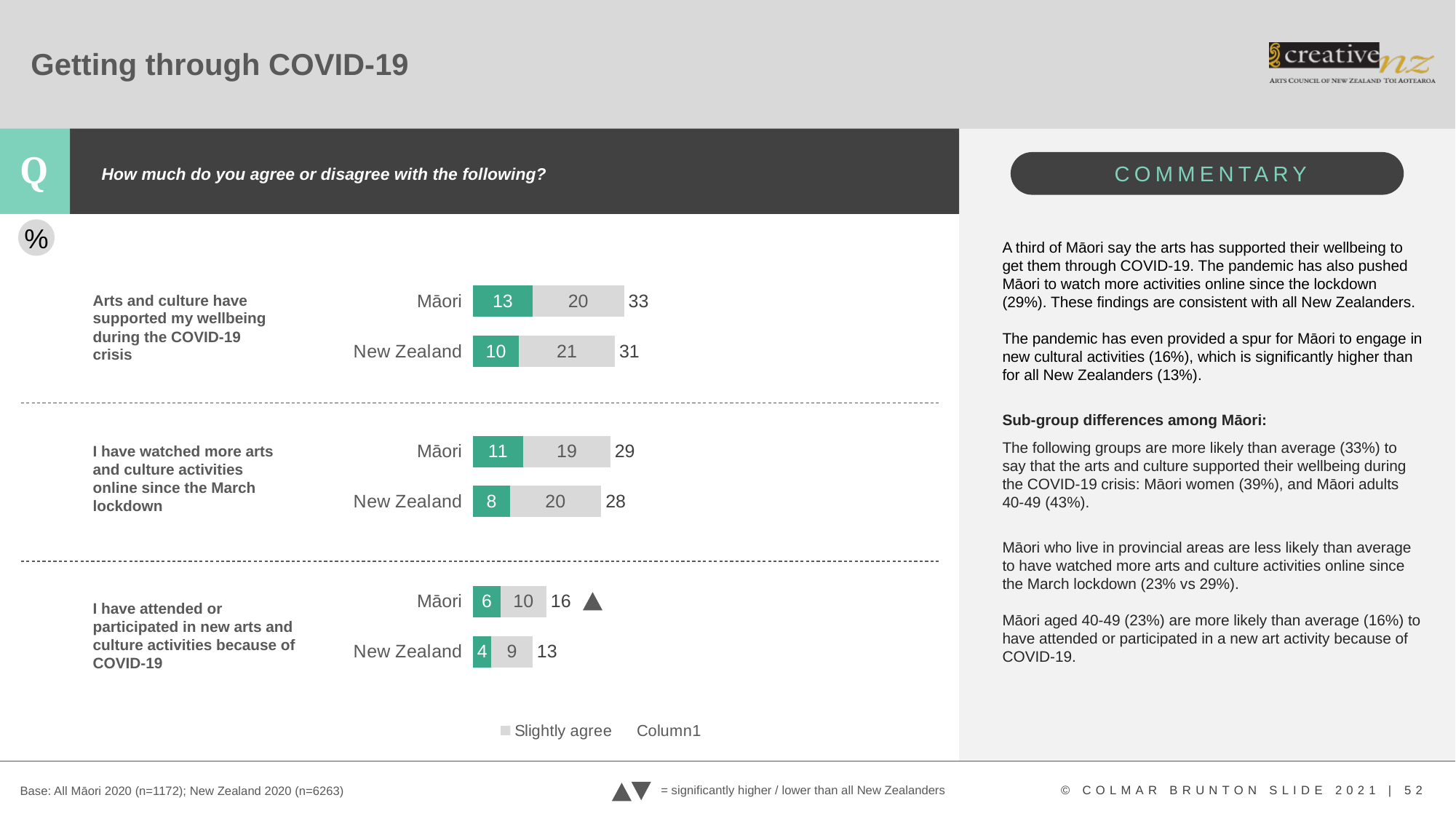
In the chart for 'Arts and culture have supported my wellbeing during the COVID-19 crisis', what is the value of the green segment for New Zealand? 10 How many entries does the legend at the bottom of the chart list? 2 In the chart for 'Arts and culture have supported my wellbeing during the COVID-19 crisis', which group has the larger total, Māori or New Zealand? Māori How many statements (question items) are shown in the chart area? 3 What type of chart is used to show the responses on this slide? Bar chart Across the three statements, which statement has the highest total for New Zealand? Arts and culture have supported my wellbeing during the COVID-19 crisis In the chart for 'I have attended or participated in new arts and culture activities because of COVID-19', what is the total value shown for New Zealand? 13 In the chart for 'I have watched more arts and culture activities online since the March lockdown', what is the sum of the green and grey segments for New Zealand? 28 In the chart for 'I have watched more arts and culture activities online since the March lockdown', what is the 'Slightly agree' (grey) value for Māori? 19 In the chart for 'I have attended or participated in new arts and culture activities because of COVID-19', what is the difference between the Māori total and the New Zealand total? 3 In the chart for 'Arts and culture have supported my wellbeing during the COVID-19 crisis', what is the total value shown for Māori? 33 Across the three statements, which statement has the lowest total for Māori? I have attended or participated in new arts and culture activities because of COVID-19